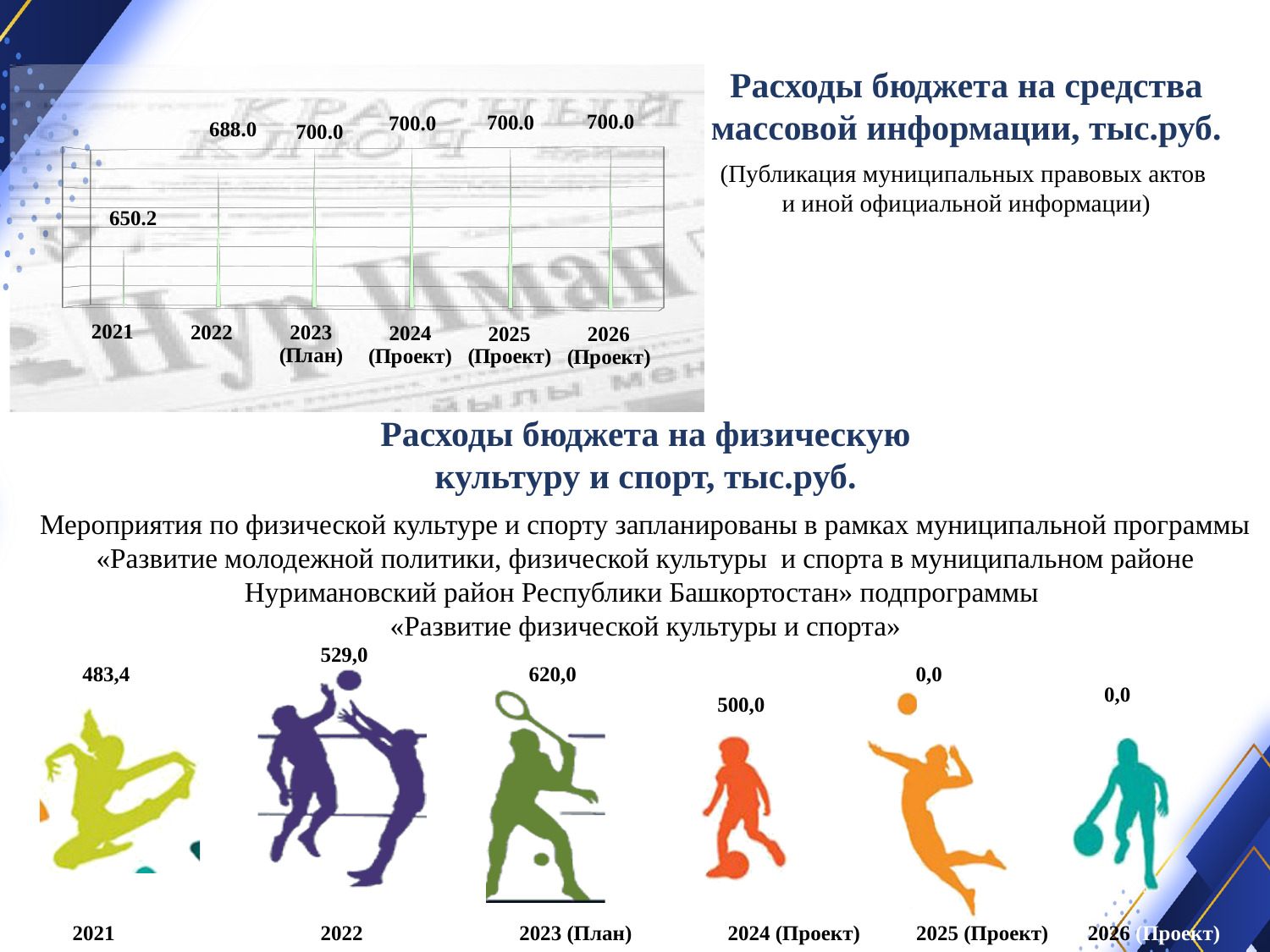
In the chart 'Расходы бюджета на средства массовой информации, тыс.руб.', which year has the lowest value? 2021 In the chart 'Расходы бюджета на средства массовой информации, тыс.руб.', do the values rise or fall from 2021 to 2023 (План)? Rise In the chart 'Расходы бюджета на средства массовой информации, тыс.руб.', which is larger, the value for 2021 or the value for 2022? 2022 In the chart 'Расходы бюджета на средства массовой информации, тыс.руб.', what is the difference between the values for 2022 and 2021? 37.8 What kind of chart is 'Расходы бюджета на средства массовой информации, тыс.руб.'? Bar chart In the infographic 'Расходы бюджета на физическую культуру и спорт, тыс.руб.', what is the value for 2023 (План)? 620,0 In the chart 'Расходы бюджета на средства массовой информации, тыс.руб.', what is the value for 2021? 650.2 In the infographic 'Расходы бюджета на физическую культуру и спорт, тыс.руб.', what is the value for 2021? 483,4 In the infographic 'Расходы бюджета на физическую культуру и спорт, тыс.руб.', which year has the highest value? 2023 (План) In the chart 'Расходы бюджета на средства массовой информации, тыс.руб.', what is the value for 2023 (План)? 700.0 In the chart 'Расходы бюджета на средства массовой информации, тыс.руб.', what is the value for 2022? 688.0 How many categories are shown on the x axis of the chart 'Расходы бюджета на средства массовой информации, тыс.руб.'? 6